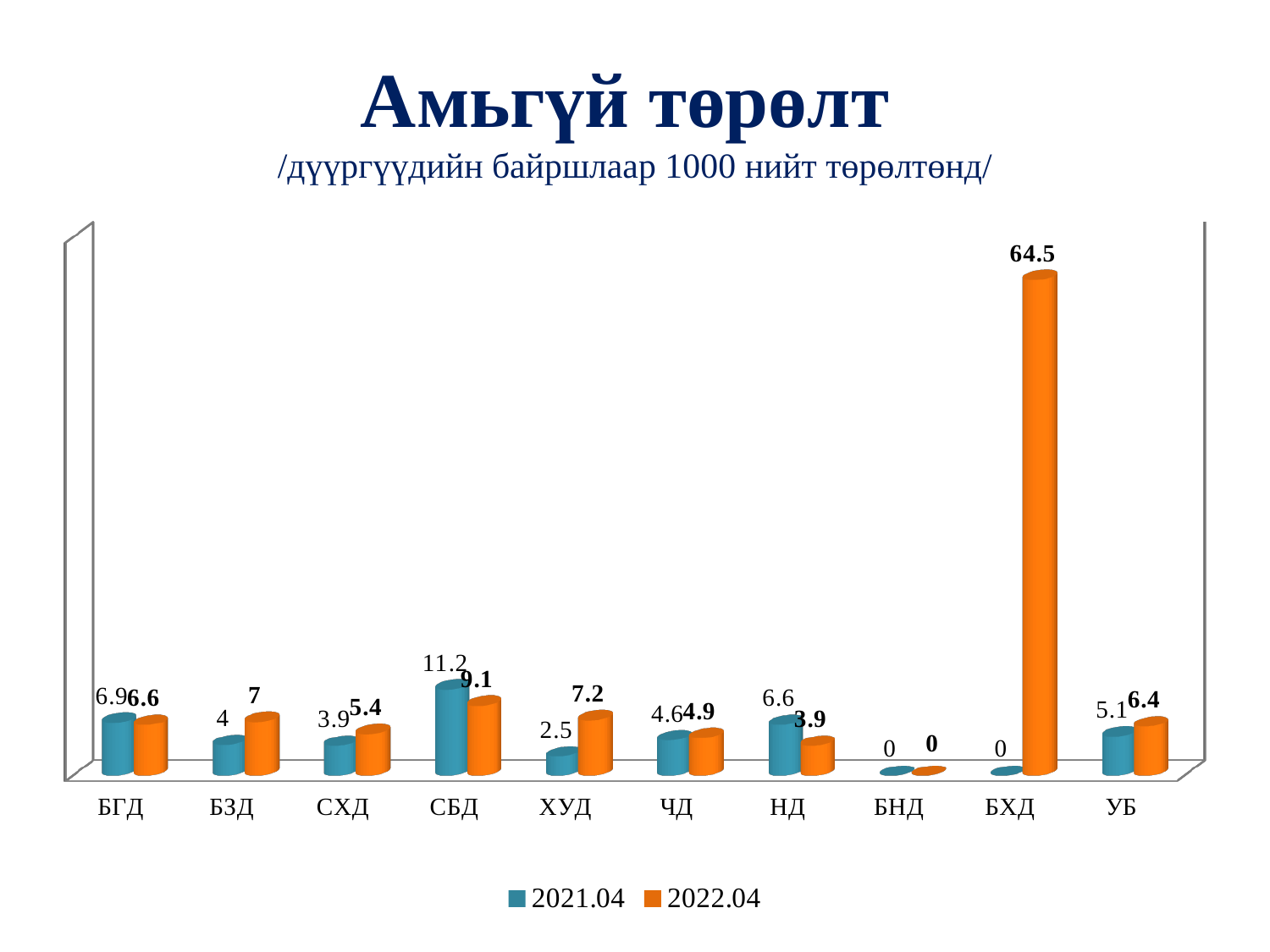
What is the title of the chart? Амьгүй төрөлт What is the value for БНД in the 2021.04 series? 0 What is the value for СБД in the 2021.04 series? 11.2 How many series does the legend list? 2 Which is larger for БЗД: the 2021.04 value or the 2022.04 value? 2022.04 Which category has the highest value in the 2022.04 series? БХД What is the value for БХД in the 2022.04 series? 64.5 What kind of chart is shown on the slide? Bar chart What is the difference between the 2021.04 and 2022.04 values for НД? 2.7 Which category has the highest value in the 2021.04 series? СБД What is the value for ХУД in the 2022.04 series? 7.2 How many districts (categories) are shown on the x axis? 10